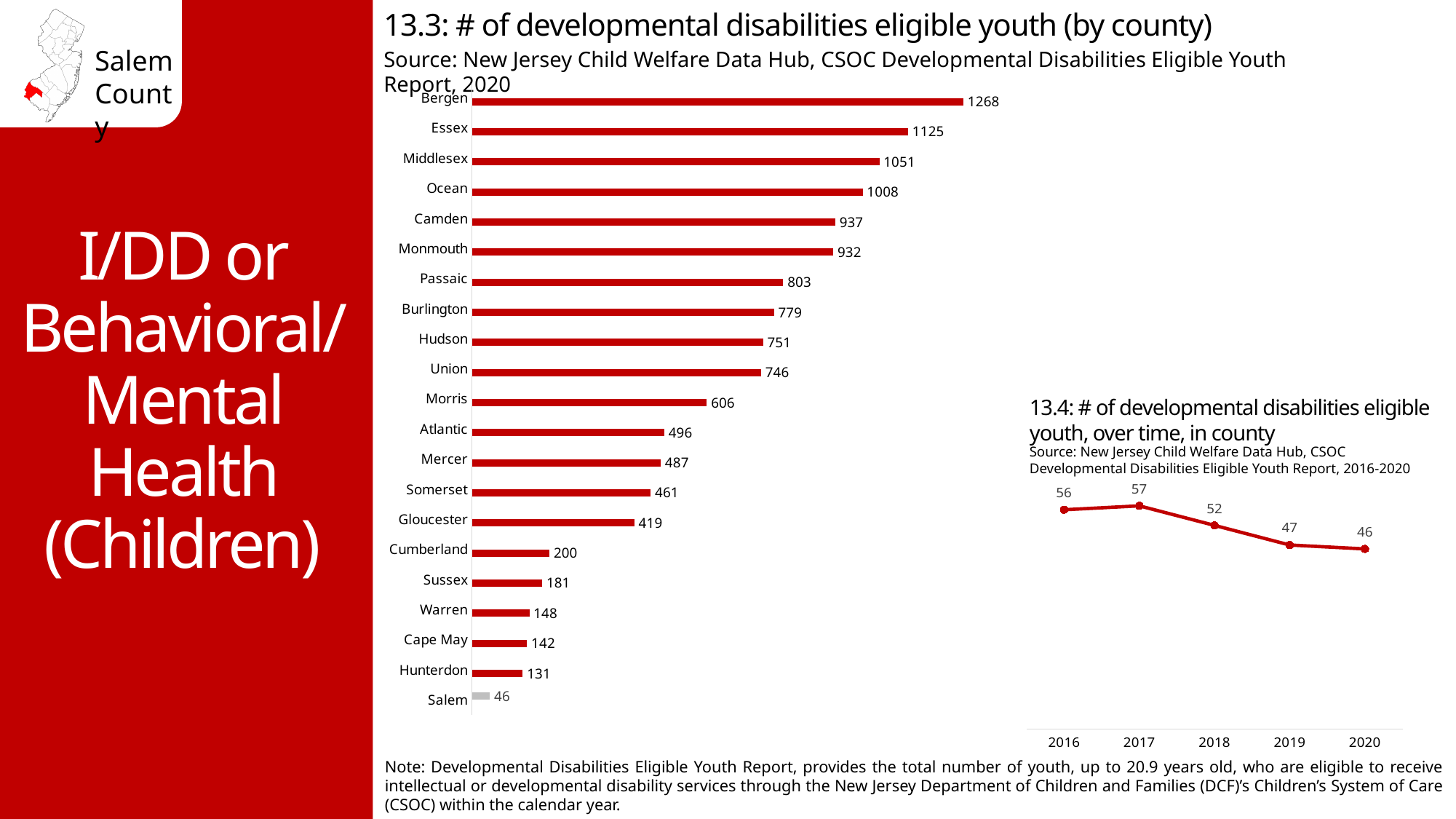
In the chart '13.4: # of developmental disabilities eligible youth, over time, in county', do the values generally rise or fall from 2017 to 2020? Fall In the chart '13.4: # of developmental disabilities eligible youth, over time, in county', what is the difference between the values for 2016 and 2020? 10 In the chart '13.3: # of developmental disabilities eligible youth (by county)', what is the value for Salem? 46 How many counties are shown in the chart '13.3: # of developmental disabilities eligible youth (by county)'? 21 In the chart '13.4: # of developmental disabilities eligible youth, over time, in county', what is the value for 2017? 57 In the chart '13.3: # of developmental disabilities eligible youth (by county)', what is the value for Bergen? 1268 In the chart '13.3: # of developmental disabilities eligible youth (by county)', what is the difference between the values for Essex and Middlesex? 74 In the chart '13.4: # of developmental disabilities eligible youth, over time, in county', which year has the lowest value? 2020 What kind of chart is '13.3: # of developmental disabilities eligible youth (by county)'? Bar chart In the chart '13.3: # of developmental disabilities eligible youth (by county)', which county has the highest value? Bergen In the chart '13.3: # of developmental disabilities eligible youth (by county)', which county has the lowest value? Salem In the chart '13.3: # of developmental disabilities eligible youth (by county)', which has a larger value, Camden or Passaic? Camden